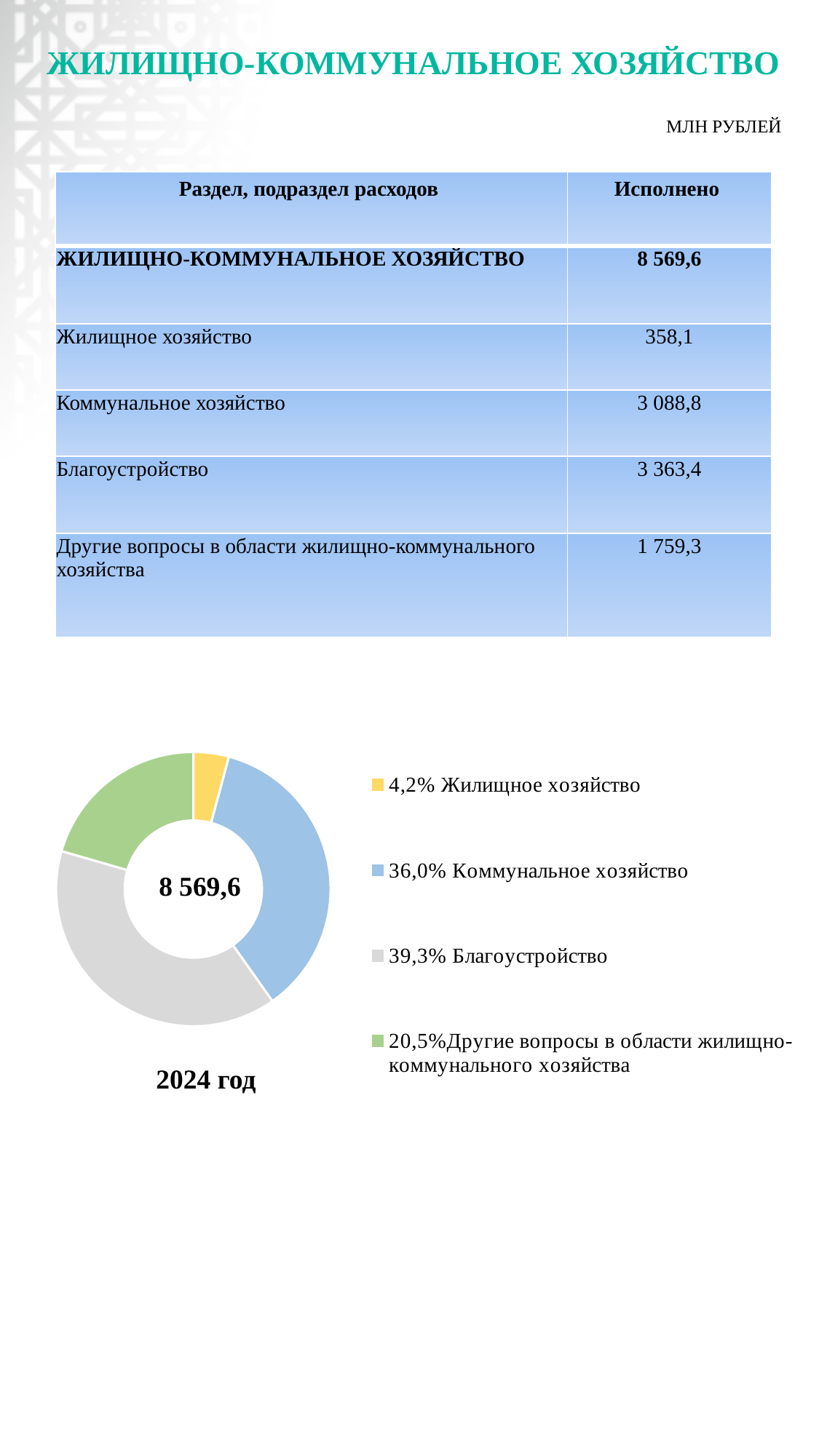
How many slices does the doughnut chart have? 4 Which category has the smallest slice in the doughnut chart? Жилищное хозяйство What share of the doughnut chart does Благоустройство take? 39,3% Which slice is larger in the doughnut chart: Коммунальное хозяйство or Другие вопросы в области жилищно-коммунального хозяйства? Коммунальное хозяйство What share of the doughnut chart does Другие вопросы в области жилищно-коммунального хозяйства take? 20,5% What year label is shown under the doughnut chart? 2024 год By how many percentage points does the share of Благоустройство exceed the share of Коммунальное хозяйство in the doughnut chart? 3,3% What share of the doughnut chart does Коммунальное хозяйство take? 36,0% Which category has the largest slice in the doughnut chart? Благоустройство What kind of chart is shown on the slide? doughnut chart What total value is printed in the centre of the doughnut chart? 8 569,6